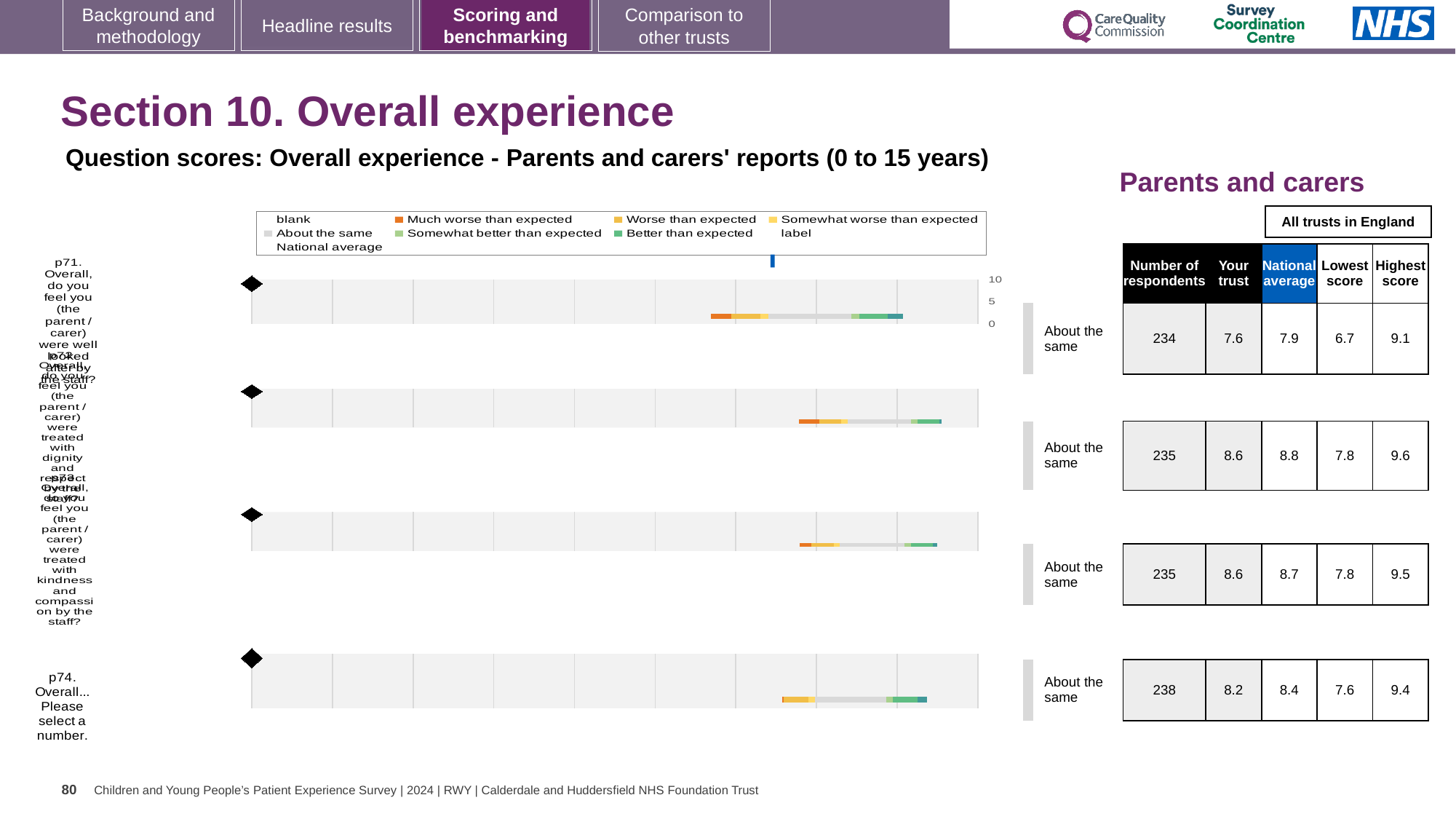
What kind of chart is used to show the question scores on this slide? bar chart What benchmark category is shown next to the chart for p71? About the same What is the highest score among all trusts in England for p73 (treated with kindness and compassion by the staff)? 9.5 What is the national average score for p72 (treated with dignity and respect by the staff)? 8.8 How many respondents answered p74 (Overall... Please select a number)? 238 Which question has the lowest 'Your trust' score? p71 What is the difference between the national average and the 'Your trust' score for p71? 0.3 What is the 'Your trust' score for p71 (Overall, do you feel you were well looked after by the staff?)? 7.6 What is the lowest score among all trusts in England for p71? 6.7 How many questions (rows) are plotted in the question scores chart? 4 For p74, which is larger: the 'Your trust' score or the national average? National average